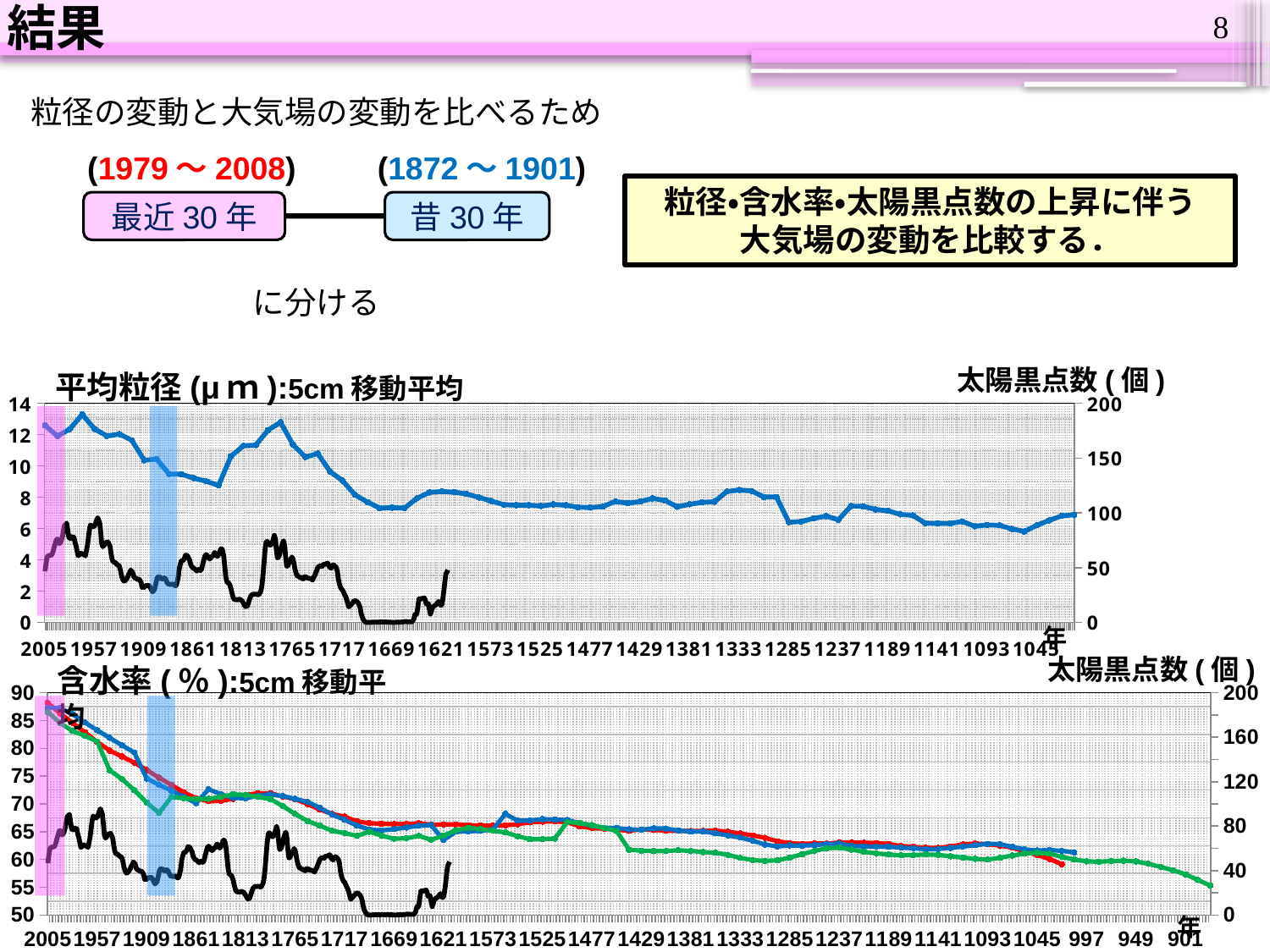
In the top chart (平均粒径), is the blue line's value at the year 1045 greater or less than 8? less In the top chart (平均粒径), is the black line's value (太陽黒点数) around the year 1669 greater or less than 50? less In the top chart (平均粒径), what is the maximum value shown on the left vertical axis? 14 In the top chart (平均粒径), does the blue line overall rise or fall when moving from 2005 on the left to 1045 on the right? fall In the top chart (平均粒径), what is the maximum value shown on the right vertical axis labelled 太陽黒点数(個)? 200 What kind of chart is the top chart titled 平均粒径(μm):5cm移動平均? line chart In the bottom chart (含水率), is the green line's value at the year 901 greater or less than 60? less How many lines are plotted in the top chart (平均粒径)? 2 How many lines are plotted in the bottom chart (含水率)? 4 In the bottom chart (含水率), what is the minimum value shown on the left vertical axis? 50 In the bottom chart (含水率), do the coloured moisture lines overall rise or fall when moving from 2005 on the left to 901 on the right? fall